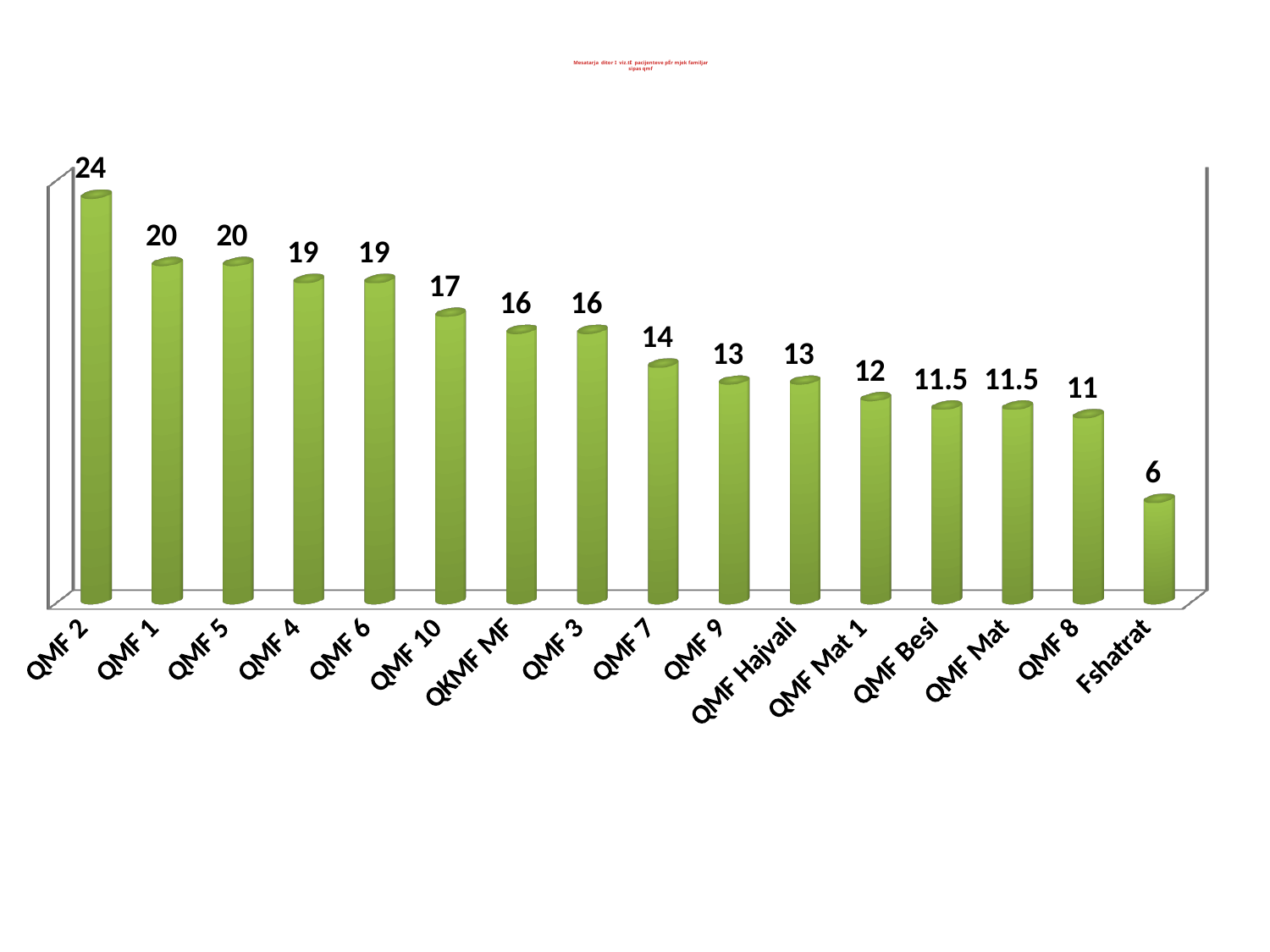
What is the value for QMF Besi? 11.5 Do the values rise or fall from left to right along the x axis? Fall Which category has the lowest value? Fshatrat What is the value for QMF 2? 24 What is the value for QMF Hajvali? 13 Which is larger, the value for QMF 4 or the value for QMF 8? QMF 4 What is the difference between the values for QMF 2 and Fshatrat? 18 Which category has the highest value? QMF 2 What is the value for QMF 10? 17 What is the difference between the values for QMF 1 and QMF 7? 6 What kind of chart is shown on the slide? Bar chart How many categories are shown on the chart? 16